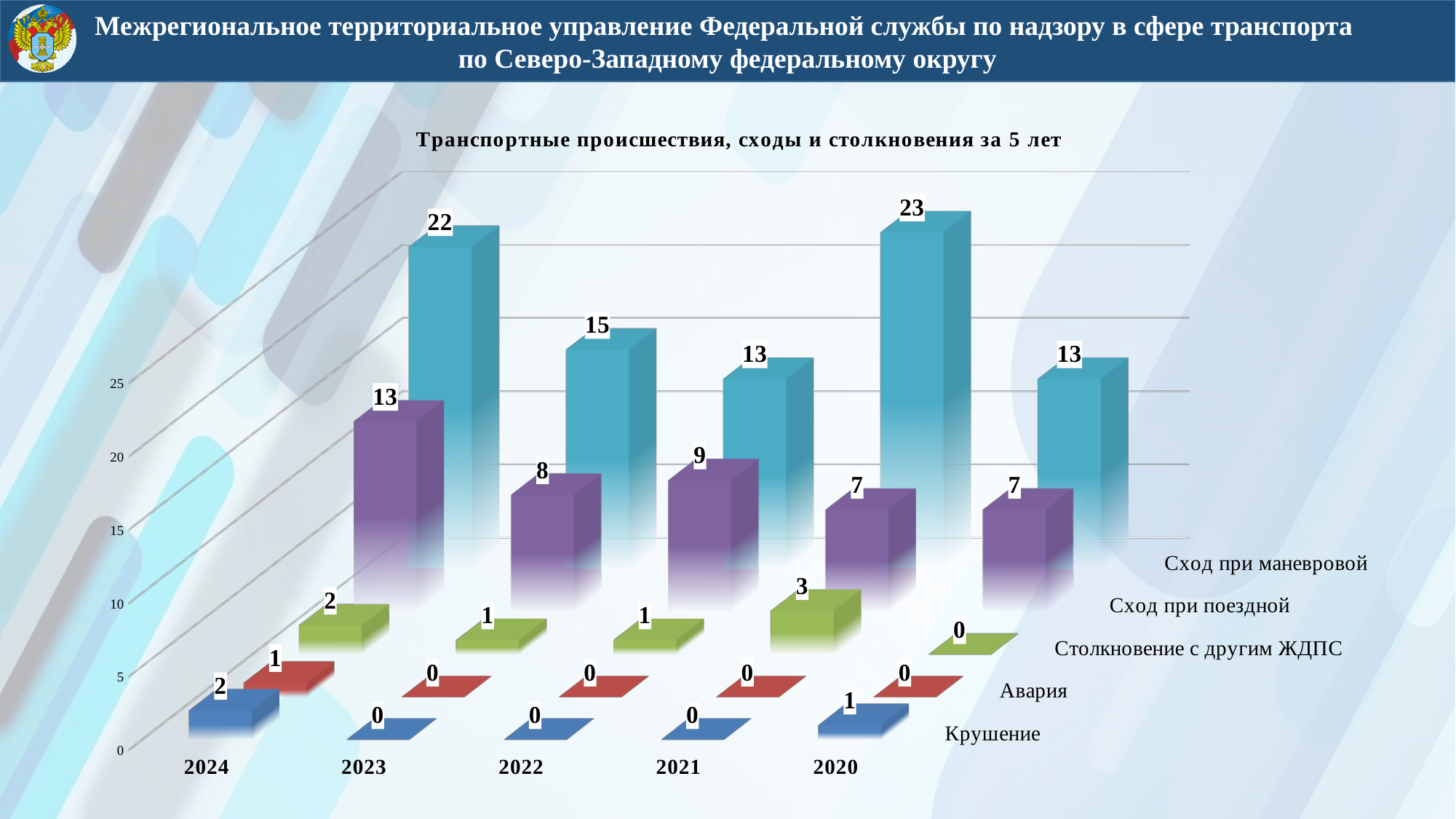
Is the value for Сход при маневровой in 2021 greater or less than 20? greater How many series does the chart show? 5 Which is larger in 2020: Крушение or Авария? Крушение What is the value for Сход при маневровой in 2024? 22 What is the value for Столкновение с другим ЖДПС in 2021? 3 In which year is the value for Сход при поездной highest? 2024 What is the title of the chart? Транспортные происшествия, сходы и столкновения за 5 лет In which year is the value for Сход при маневровой highest? 2021 What is the value for Сход при поездной in 2022? 9 What is the difference between Сход при маневровой and Сход при поездной in 2023? 7 How many years are shown on the x axis? 5 What type of chart is shown on the slide? bar chart